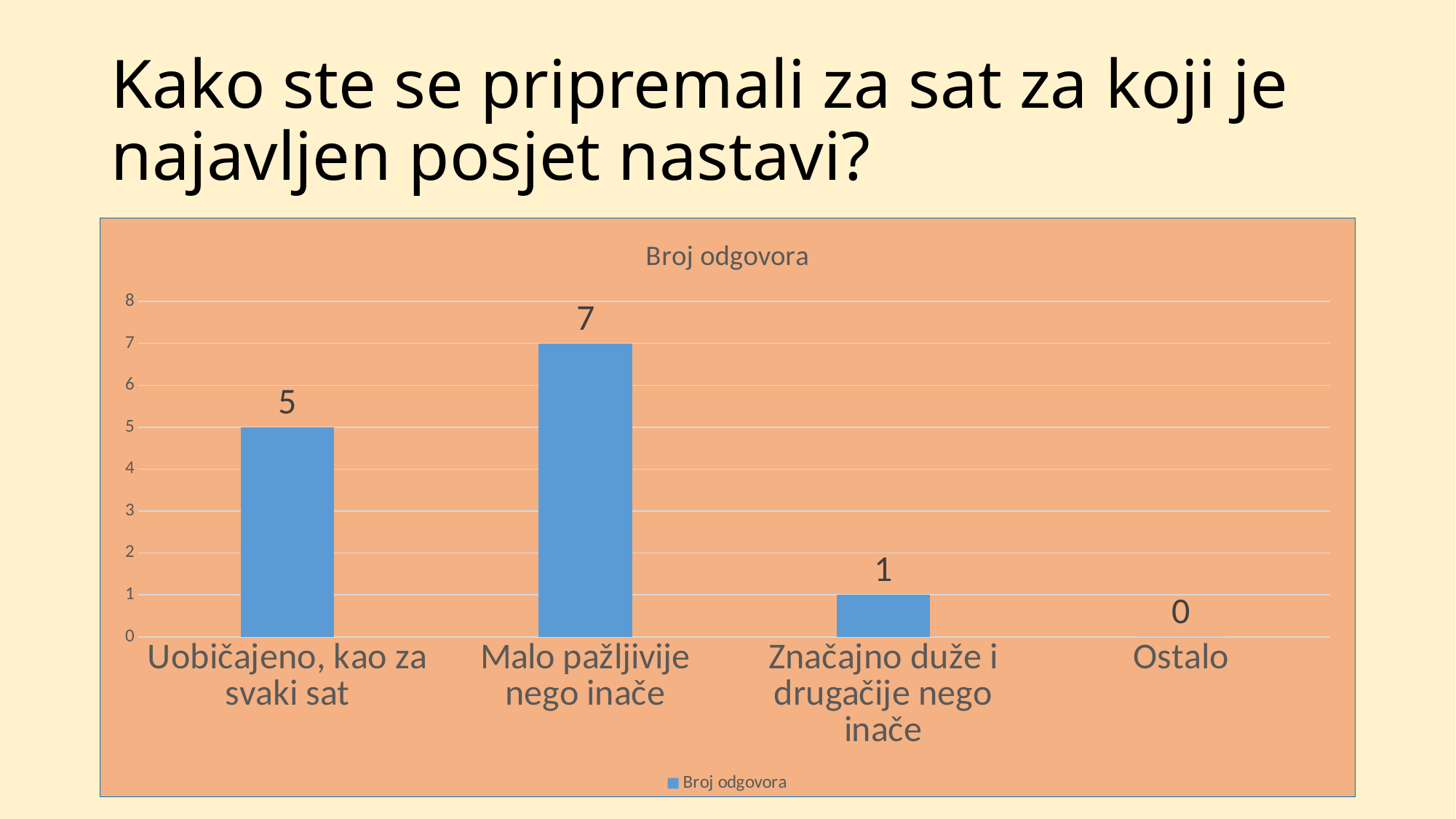
How many series does the legend list? 1 Which is larger: the value for "Uobičajeno, kao za svaki sat" or the value for "Značajno duže i drugačije nego inače"? Uobičajeno, kao za svaki sat What is the value for "Malo pažljivije nego inače"? 7 What is the value for "Uobičajeno, kao za svaki sat"? 5 What is the difference between the values for "Malo pažljivije nego inače" and "Uobičajeno, kao za svaki sat"? 2 What is the title of the chart? Broj odgovora Which category has the lowest value? Ostalo How many categories are shown on the x axis? 4 What is the value for "Ostalo"? 0 Which category has the highest value? Malo pažljivije nego inače What kind of chart is shown on the slide? Bar chart What is the value for "Značajno duže i drugačije nego inače"? 1